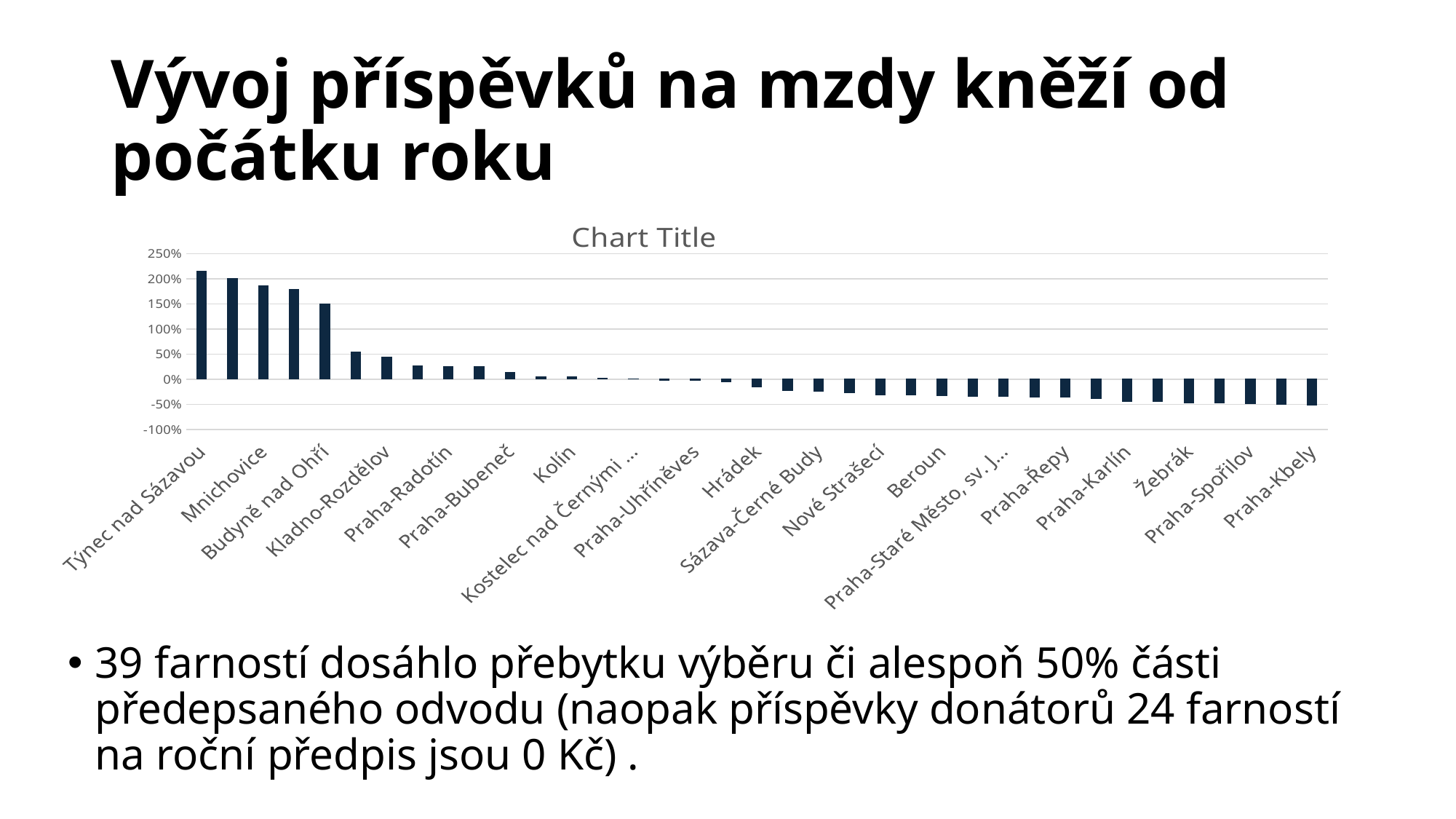
Is the value for Kladno-Rozdělov greater or less than 100%? less What kind of chart is shown on the slide? bar chart Is the value for Praha-Karlín greater or less than 0%? less Is the value for Praha-Kbely greater or less than 0%? less Which is larger, the value for Týnec nad Sázavou or the value for Praha-Kbely? Týnec nad Sázavou Which is larger, the value for Mnichovice or the value for Kladno-Rozdělov? Mnichovice Which category has the highest value in the chart? Týnec nad Sázavou What is the title shown above the chart? Chart Title Do the values rise or fall moving from left to right along the x axis? fall